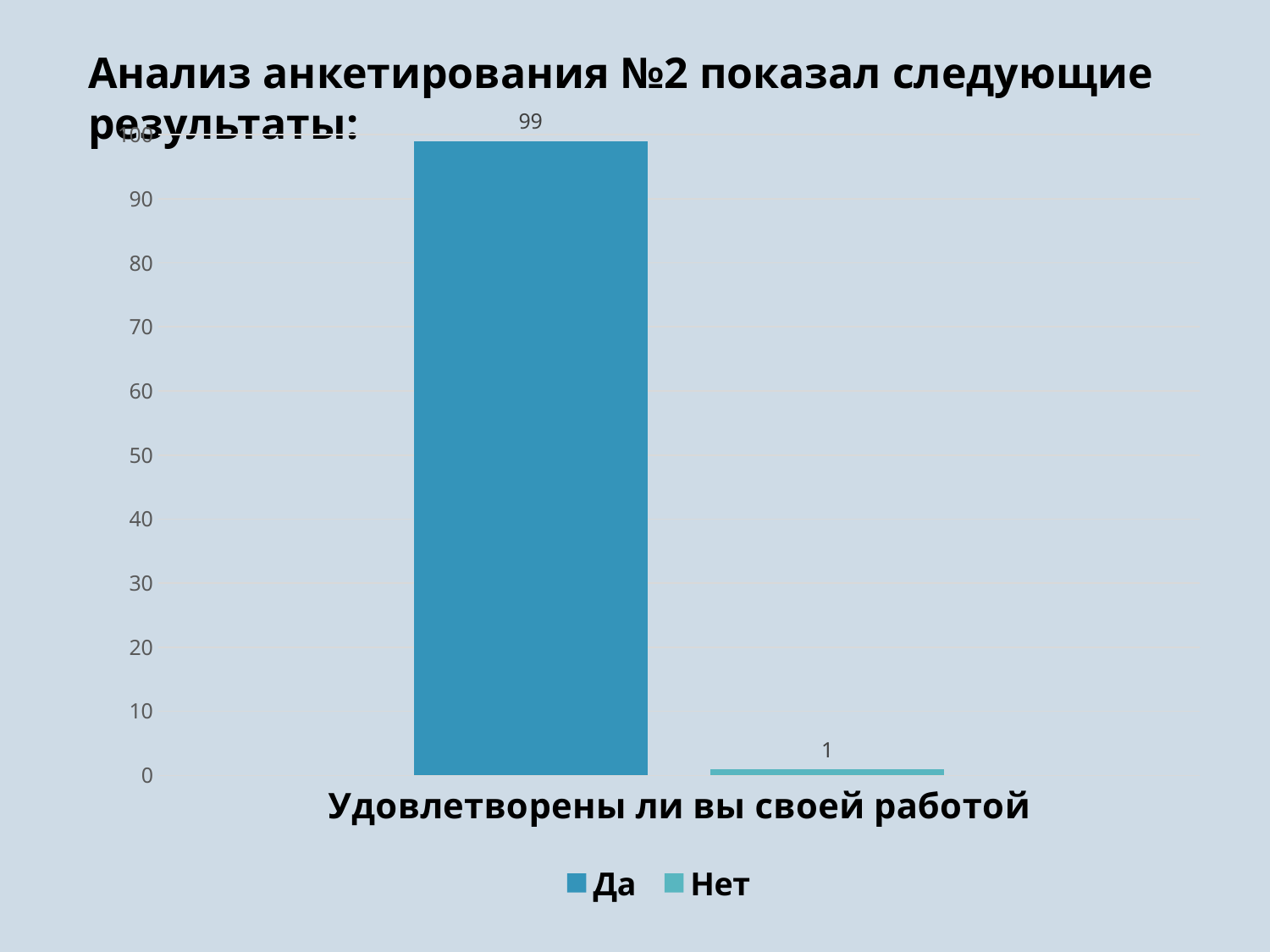
Is the value for "Да" greater or less than 50? greater What is the category label shown on the x axis of the chart? Удовлетворены ли вы своей работой What kind of chart is shown on the slide? bar chart Which series has the lowest value? Нет Is the value for "Нет" greater or less than 10? less How many series does the legend list? 2 What is the value for "Нет" in the chart? 1 Which is larger, the value for "Да" or the value for "Нет"? Да Which series has the highest value? Да What is the difference between the values for "Да" and "Нет"? 98 What is the value for "Да" in the chart? 99 What is the total of the values for "Да" and "Нет"? 100